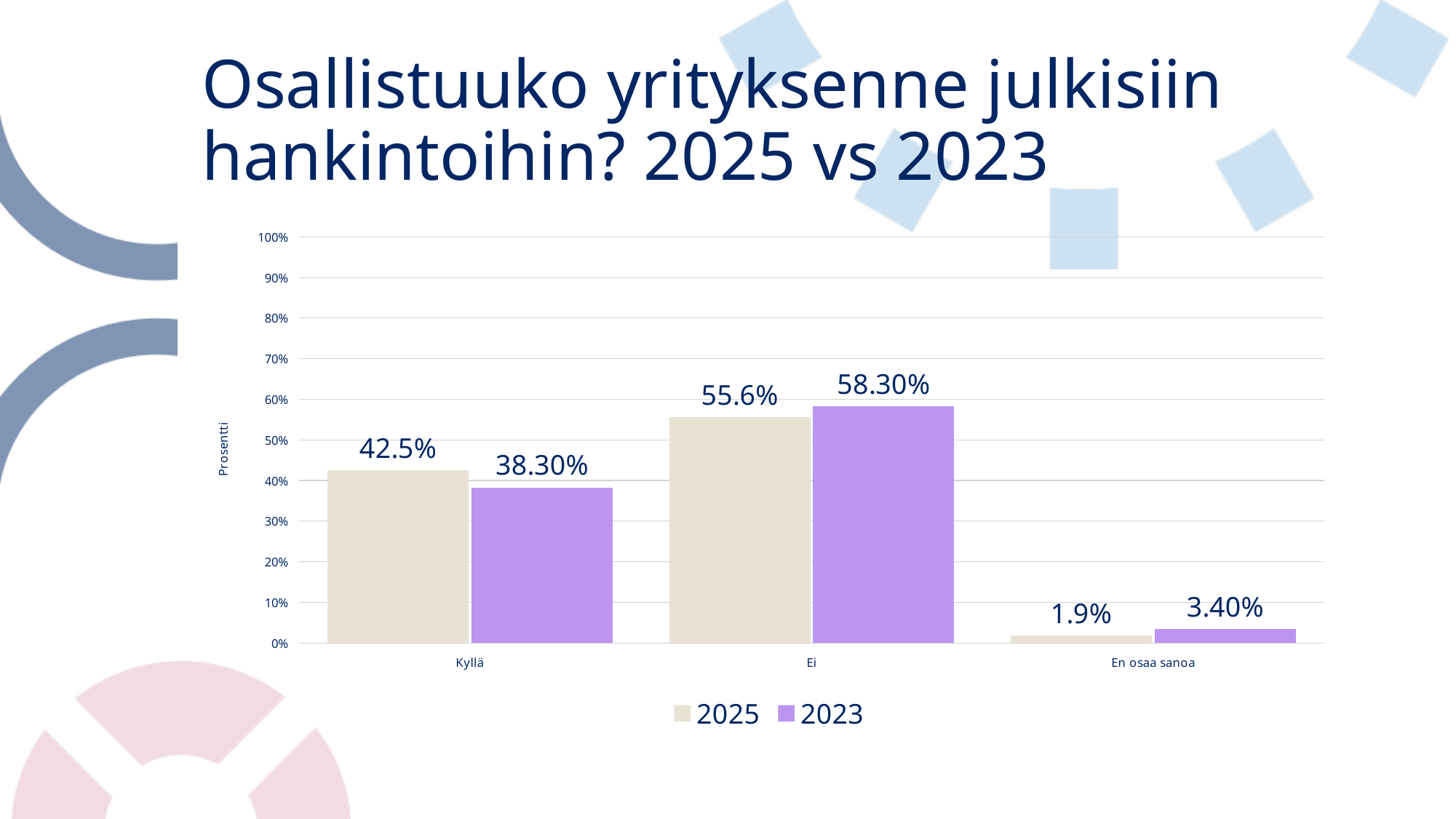
Is the 2023 value for Kyllä greater or less than 40%? less Which category has the highest value in the 2023 series? Ei Which is larger for Ei: the 2025 value or the 2023 value? 2023 What is the value for Kyllä in the 2025 series? 42.5% What is the value for Ei in the 2023 series? 58.30% What is the difference between the 2025 and 2023 values for Kyllä? 4.2% What kind of chart is shown on the slide? bar chart How many categories are shown on the x axis? 3 Which category has the lowest value in the 2025 series? En osaa sanoa How many series does the legend list? 2 What is the label of the y axis? Prosentti What is the value for En osaa sanoa in the 2025 series? 1.9%